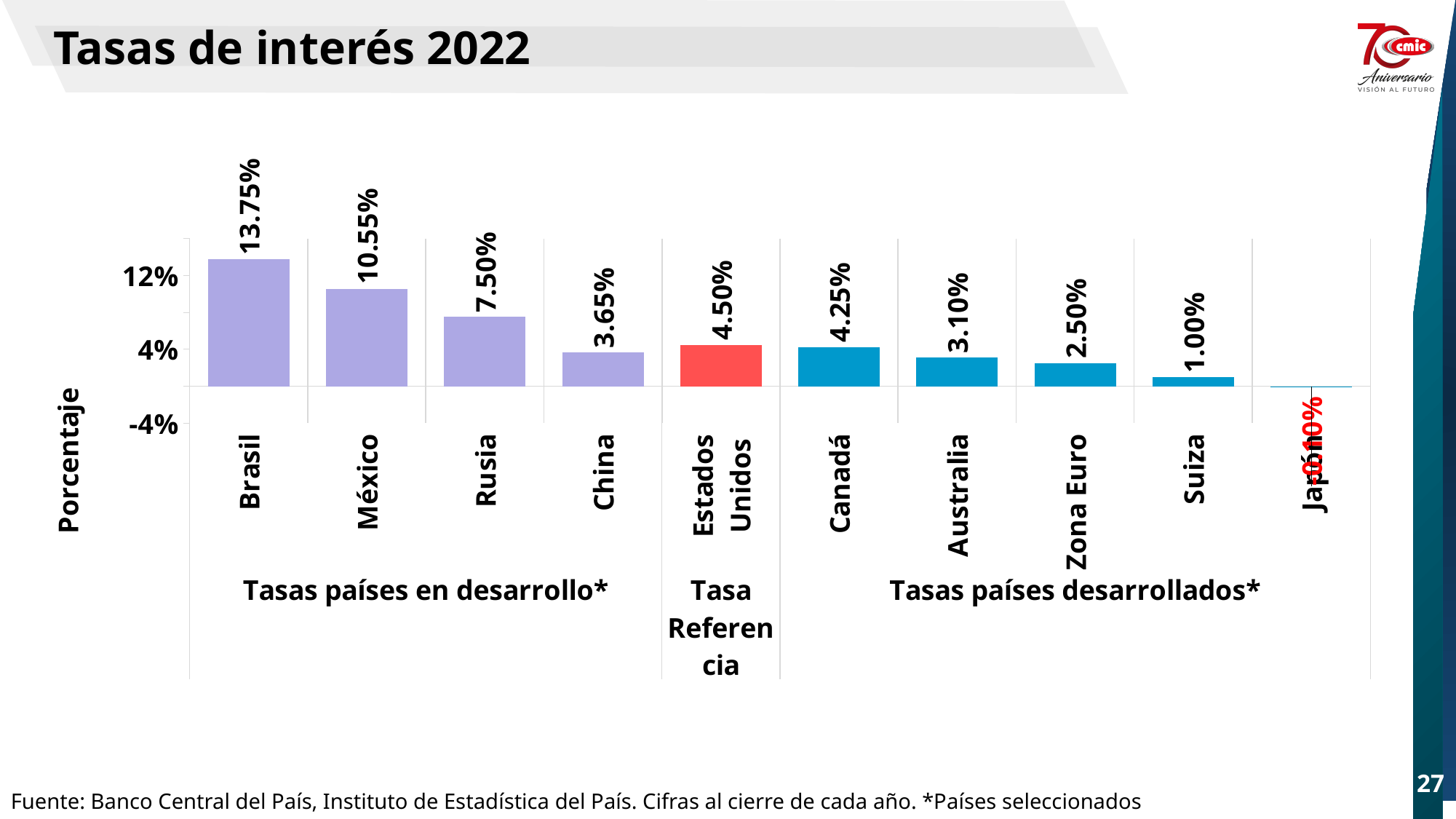
Which has a higher interest rate, Rusia or China? Rusia What is the value shown for Estados Unidos? 4.50% Which has a higher interest rate, Australia or Suiza? Australia What is the difference between the interest rates of Brasil and México? 3.20% What is the interest rate shown for Zona Euro? 2.50% What is the interest rate shown for Brasil? 13.75% How many countries or regions are shown on the chart? 10 Which category has the lowest value on the chart? Japón What type of chart is shown on the slide? Bar chart Which country has the highest interest rate on the chart? Brasil What is the interest rate shown for México? 10.55% What is the difference between the values for Estados Unidos and Canadá? 0.25%